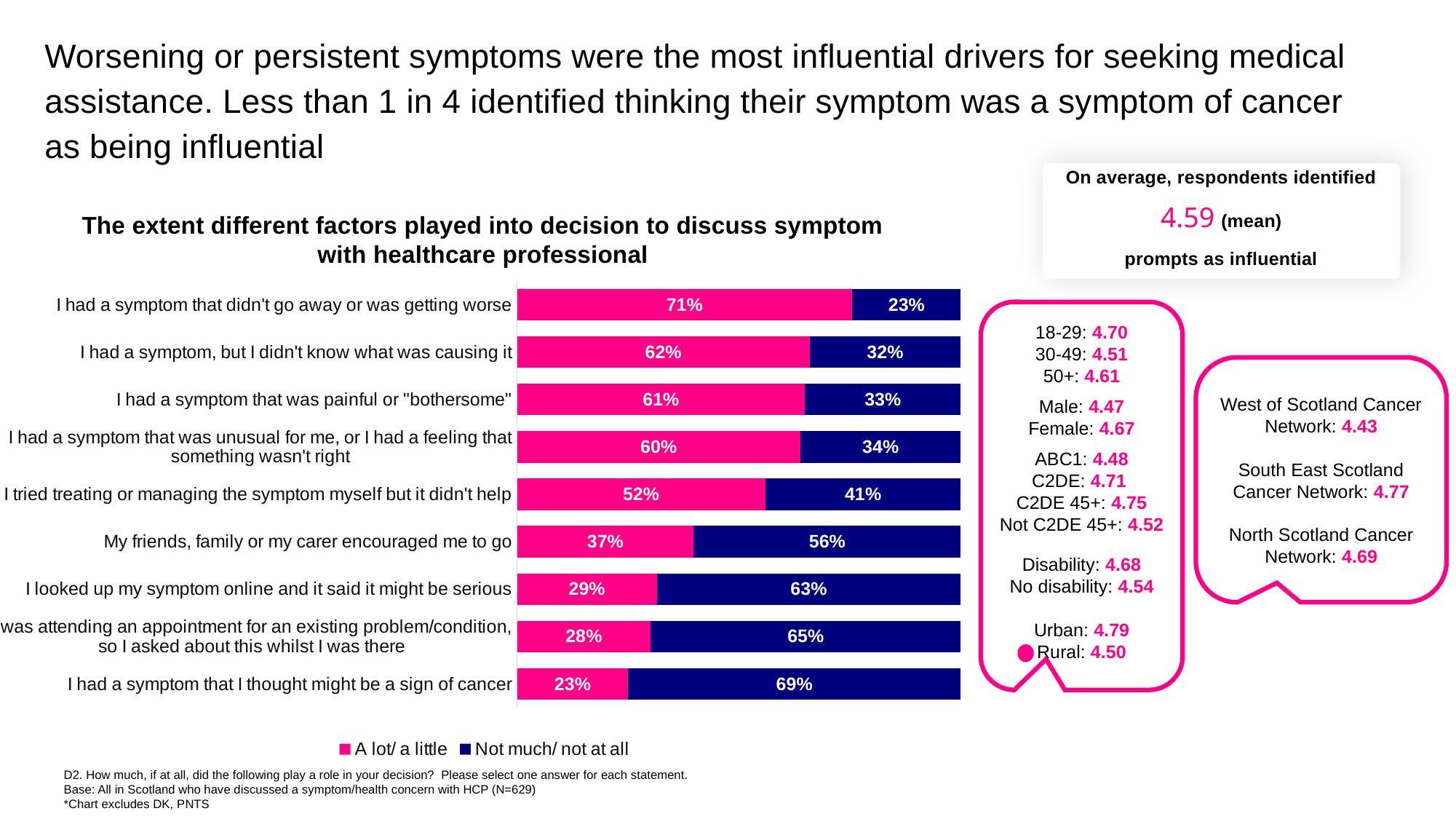
Which colour represents "Not much/ not at all" in the chart? Dark blue What percentage said "A lot/ a little" for "I had a symptom that didn't go away or was getting worse"? 71% What is the total of the two segments for "I tried treating or managing the symptom myself but it didn't help"? 93% How many series does the legend list? 2 What kind of chart is shown on the slide? Stacked bar chart What percentage said "Not much/ not at all" for "My friends, family or my carer encouraged me to go"? 56% Which factor has the lowest "A lot/ a little" percentage? I had a symptom that I thought might be a sign of cancer Which factor has the highest "A lot/ a little" percentage? I had a symptom that didn't go away or was getting worse Which is larger: the "Not much/ not at all" percentage for "I looked up my symptom online and it said it might be serious" or for "I tried treating or managing the symptom myself but it didn't help"? I looked up my symptom online and it said it might be serious What is the difference between the "A lot/ a little" percentages for "I had a symptom, but I didn't know what was causing it" and "I had a symptom that was painful or "bothersome""? 1% How many factors (categories) are shown in the chart? 9 What percentage said "A lot/ a little" for "I had a symptom that I thought might be a sign of cancer"? 23%